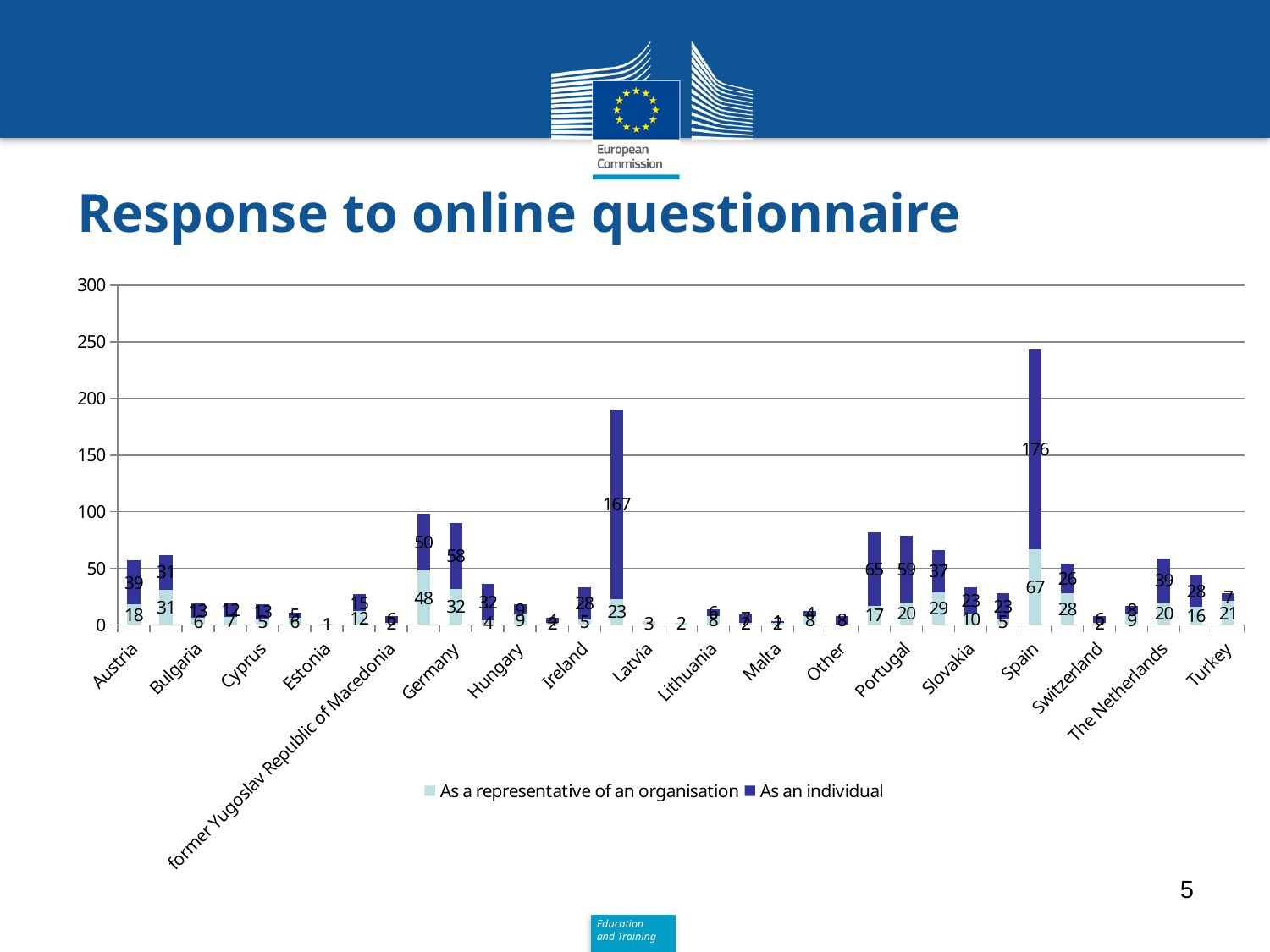
What is the value for Spain in the 'As an individual' series? 176 What is the value for Austria in the 'As a representative of an organisation' series? 18 How many series does the legend list? 2 What kind of chart is shown on the slide? Stacked bar chart What is the value for Austria in the 'As an individual' series? 39 What is the title of the chart? Response to online questionnaire Which country has the highest total number of responses? Spain For Spain, what is the difference between the 'As an individual' value and the 'As a representative of an organisation' value? 109 What is the value for Spain in the 'As a representative of an organisation' series? 67 Is the total stacked bar for Spain greater or less than 200? greater What are the two series named in the legend? As a representative of an organisation; As an individual What is the total number of responses for Spain (both series combined)? 243